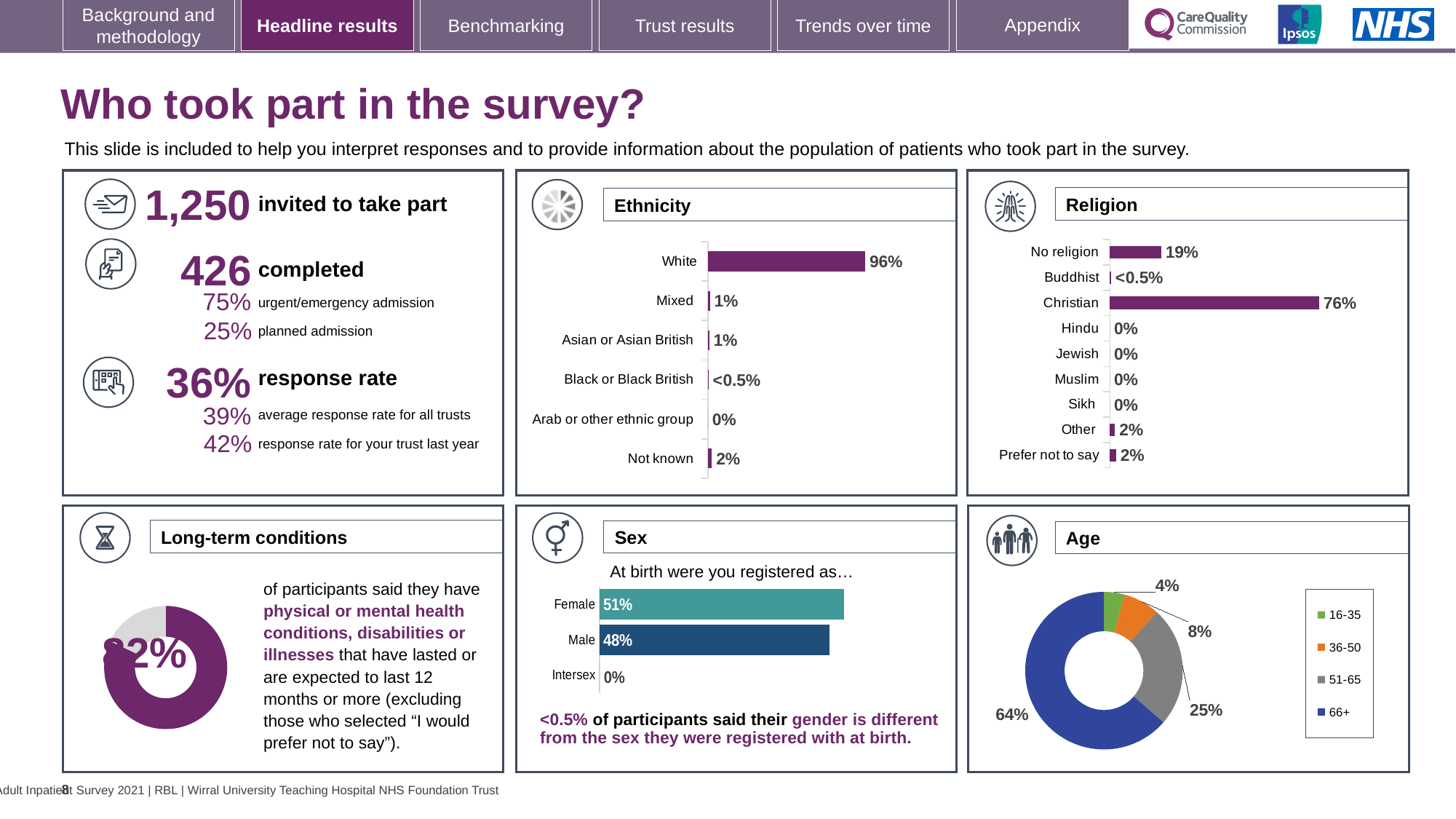
In the Ethnicity chart, what is the value for Not known? 2% In the Religion chart, what is the value for Buddhist? <0.5% In the Age chart, what share of participants were aged 66+? 64% In the Ethnicity chart, what percentage of participants were White? 96% In the Sex chart, what percentage of participants were registered as Female at birth? 51% In the Sex chart, which is larger, Female or Male? Female In the Religion chart, what is the value for No religion? 19% In the Ethnicity chart, which category has the highest value? White How many categories are shown in the Ethnicity chart? 6 In the Religion chart, what is the difference between the Christian and No religion values? 57% In the Religion chart, what percentage of participants were Christian? 76% How many age groups does the legend of the Age chart list? 4